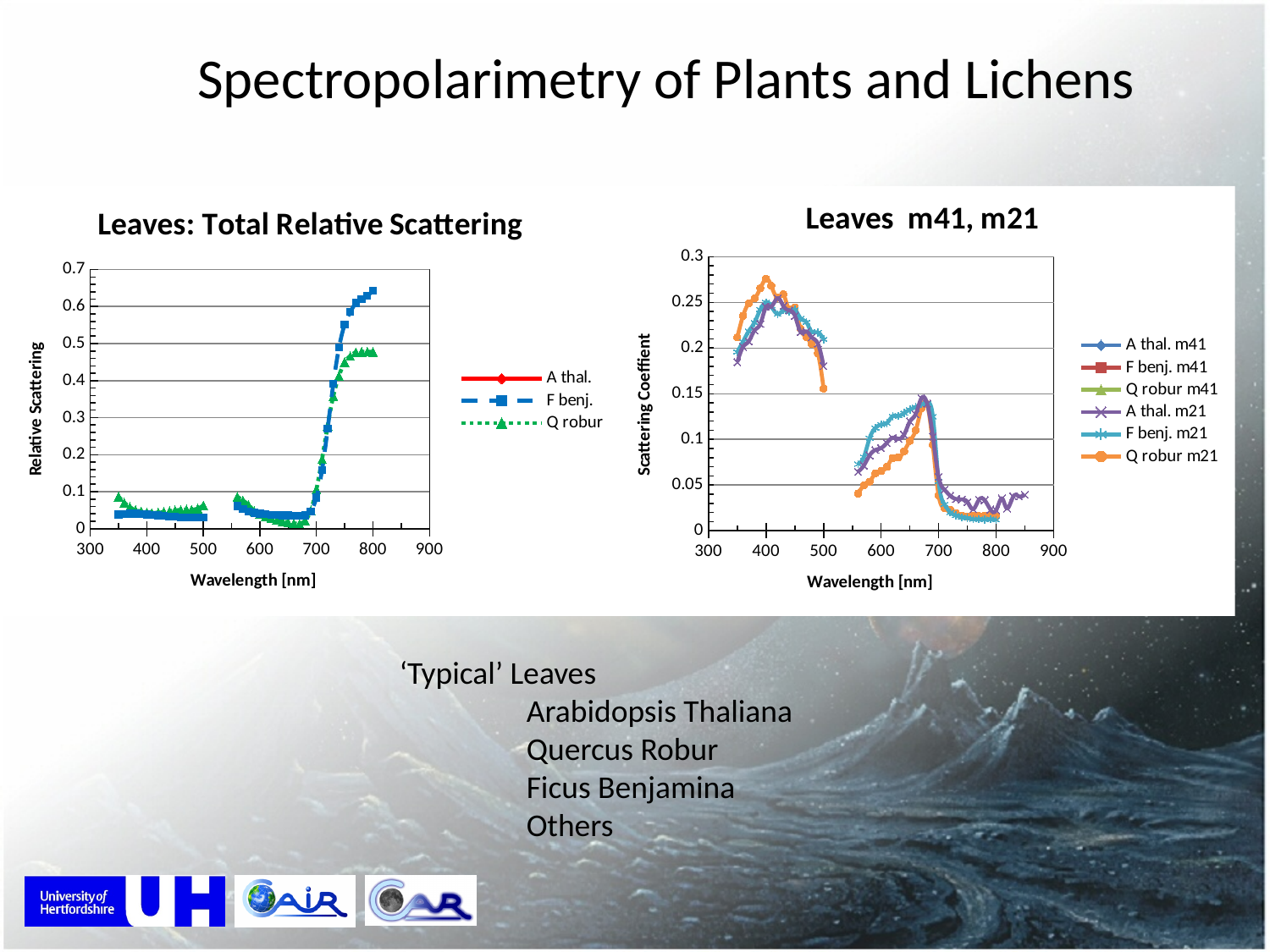
In the 'Leaves m41, m21' chart, what is the title of the horizontal axis? Wavelength [nm] In the 'Leaves: Total Relative Scattering' chart, is the value for Q robur at 800 nm greater or less than 0.4? greater In the 'Leaves: Total Relative Scattering' chart, does the F benj. series rise or fall between 700 nm and 800 nm? rise In the 'Leaves m41, m21' chart, is the peak value of Q robur m21 near 400 nm greater or less than 0.25? greater How many series does the legend of the 'Leaves m41, m21' chart list? 6 In the 'Leaves m41, m21' chart, do the series rise or fall between 700 nm and 800 nm? fall In the 'Leaves: Total Relative Scattering' chart, is the value for F benj. at 800 nm greater or less than 0.6? greater In the 'Leaves: Total Relative Scattering' chart, what is the title of the vertical axis? Relative Scattering What kind of chart is the 'Leaves: Total Relative Scattering' chart? line chart In the 'Leaves: Total Relative Scattering' chart, which series has the larger value at 800 nm, F benj. or Q robur? F benj. How many series does the legend of the 'Leaves: Total Relative Scattering' chart list? 3